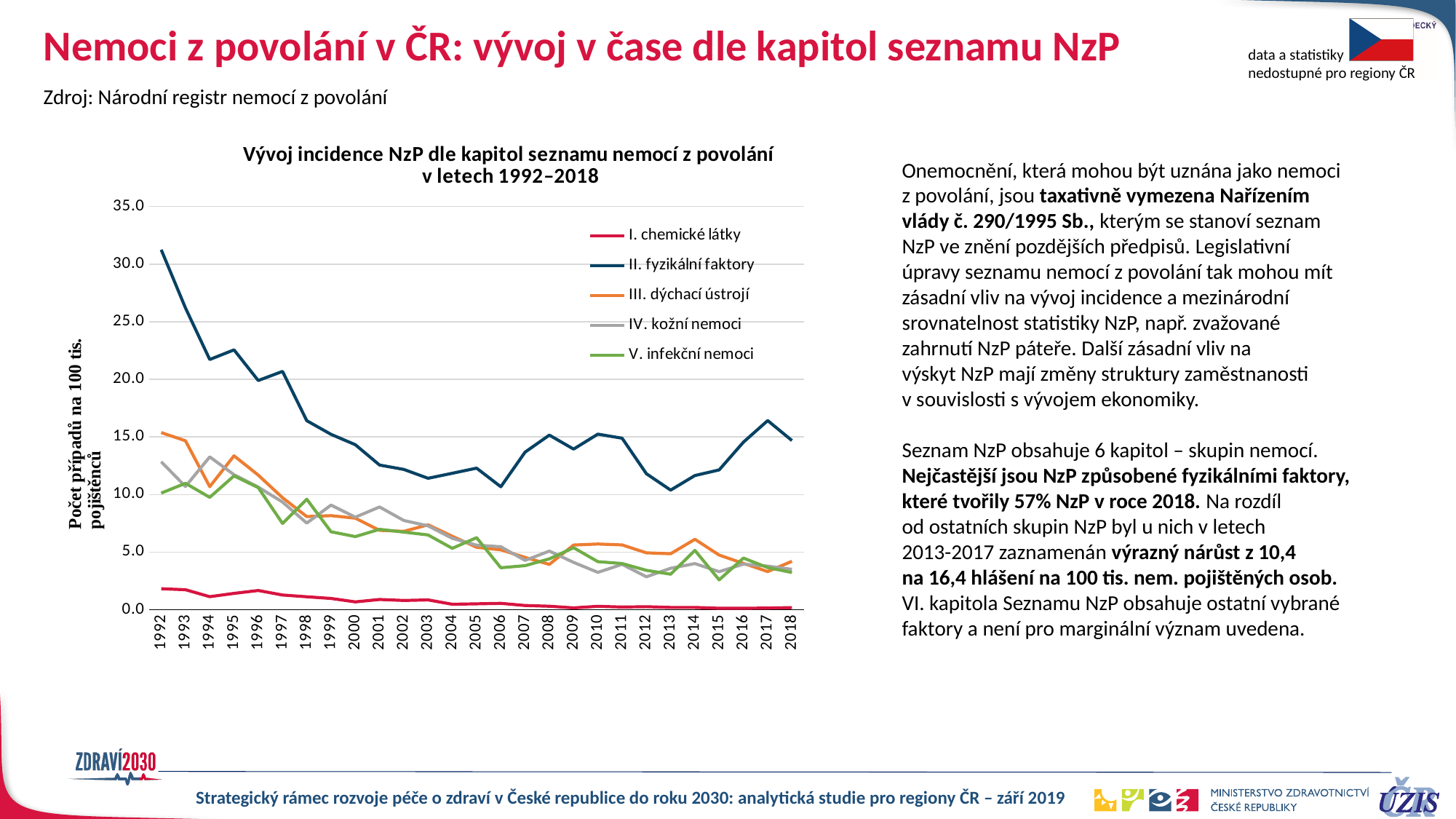
Does the value for II. fyzikální faktory rise or fall overall from 1992 to 2018? fall Which series has the lowest value in 2018? I. chemické látky How many years are plotted along the x axis? 27 Is the value for II. fyzikální faktory in 2018 greater or less than 10.0? greater In 1992, which is larger: II. fyzikální faktory or III. dýchací ústrojí? II. fyzikální faktory What kind of chart is shown on the slide? line chart How many series does the legend list? 5 Is the value for II. fyzikální faktory in 1992 greater or less than 25.0? greater What is the label of the y axis? Počet případů na 100 tis. pojištěnců Is the value for III. dýchací ústrojí in 1992 greater or less than 10.0? greater Which series has the highest value in 1992? II. fyzikální faktory